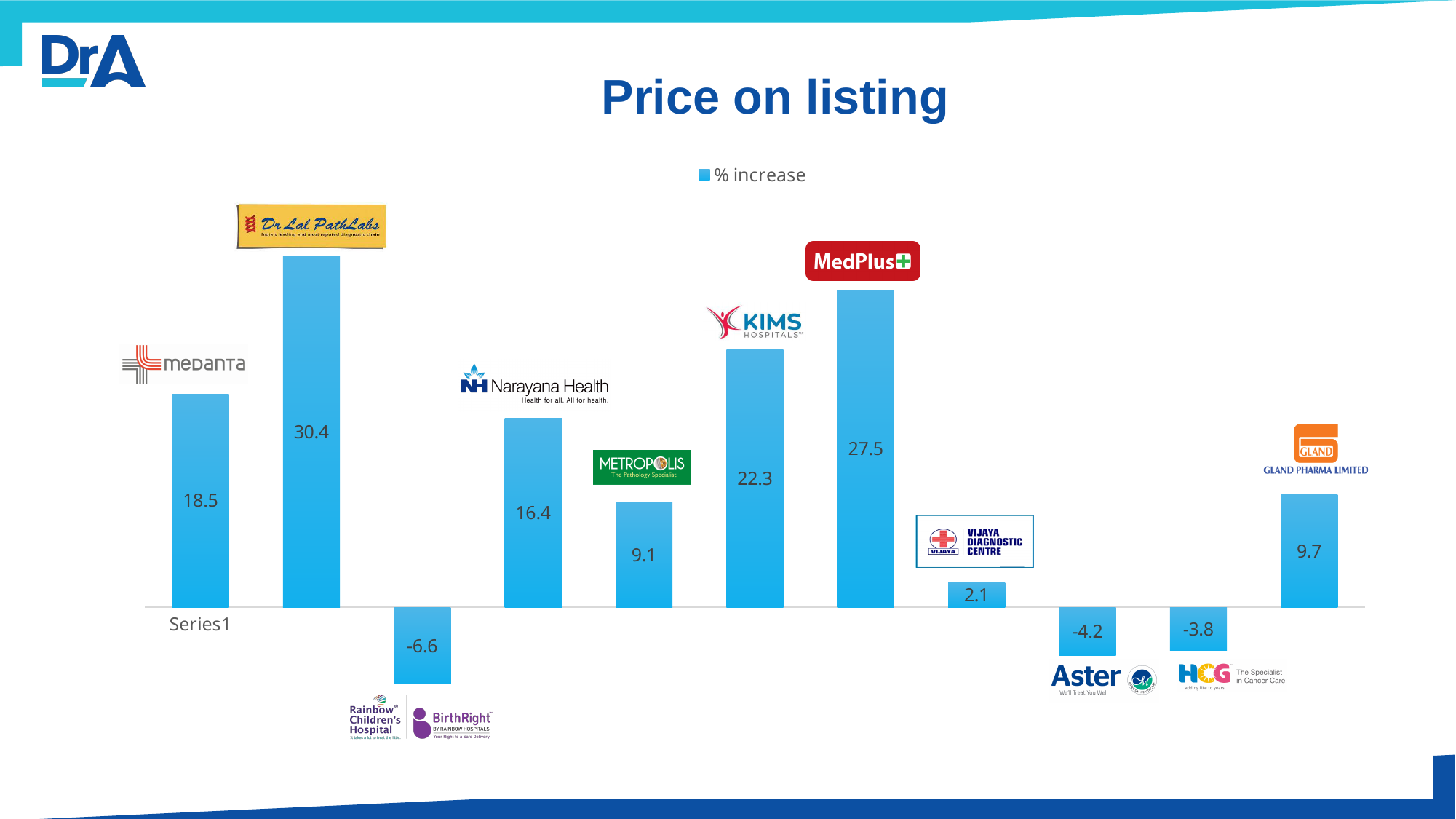
How many bars are plotted in the chart? 11 What is the % increase value for Gland Pharma Limited? 9.7 Which has a larger % increase, Medanta or Narayana Health? Medanta Which company has the lowest % increase on listing? Rainbow Children's Hospital What is the % increase value for Rainbow Children's Hospital? -6.6 Which company has the highest % increase on listing? Dr Lal PathLabs What type of chart is shown on the slide? Bar chart What is the % increase value for MedPlus? 27.5 What is the difference between the % increase for MedPlus and KIMS Hospitals? 5.2 What is the % increase value for Dr Lal PathLabs? 30.4 What is the title of the chart on the slide? Price on listing How many series does the legend list? 1